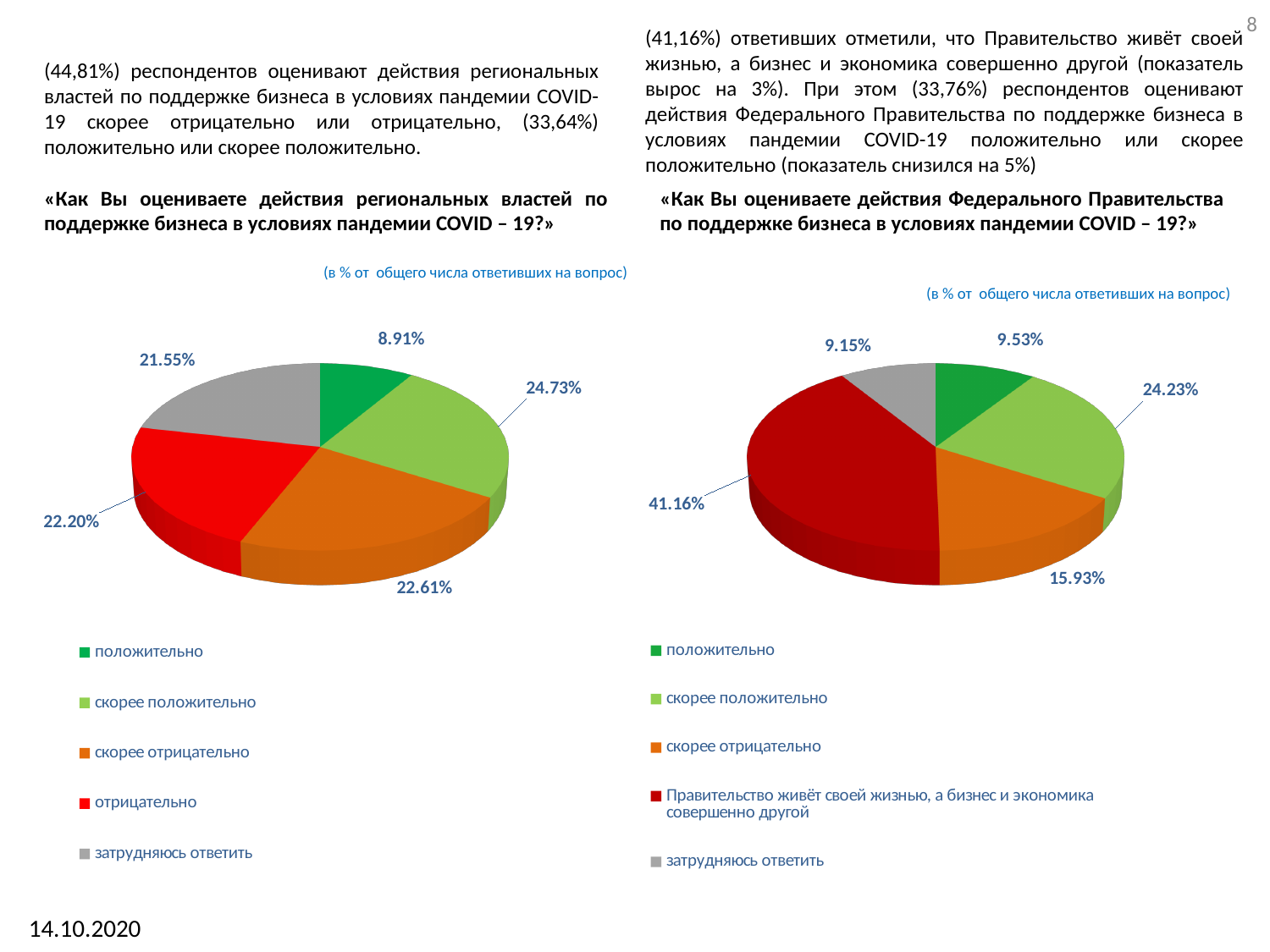
In the left chart (regional authorities), what share of respondents answered «скорее положительно»? 24.73% In the right chart (Federal Government), what share of respondents answered «скорее отрицательно»? 15.93% How many entries does the legend of the right chart (Federal Government) list? 5 In the left chart (regional authorities), which answer has the smallest share? положительно In the right chart (Federal Government), which is larger: the share for «положительно» or for «затрудняюсь ответить»? положительно In the left chart (regional authorities), which answer has the largest share? скорее положительно In the right chart (Federal Government), what share of respondents chose «Правительство живёт своей жизнью, а бизнес и экономика совершенно другой»? 41.16% In the right chart (Federal Government), which answer has the smallest share? затрудняюсь ответить In the left chart (regional authorities), what colour is the slice for «затрудняюсь ответить»? gray In the left chart (regional authorities), what is the difference between the shares for «скорее отрицательно» and «отрицательно»? 0.41% What kind of chart is the left chart about regional authorities? pie chart In the left chart (regional authorities), what share of respondents answered «положительно»? 8.91%